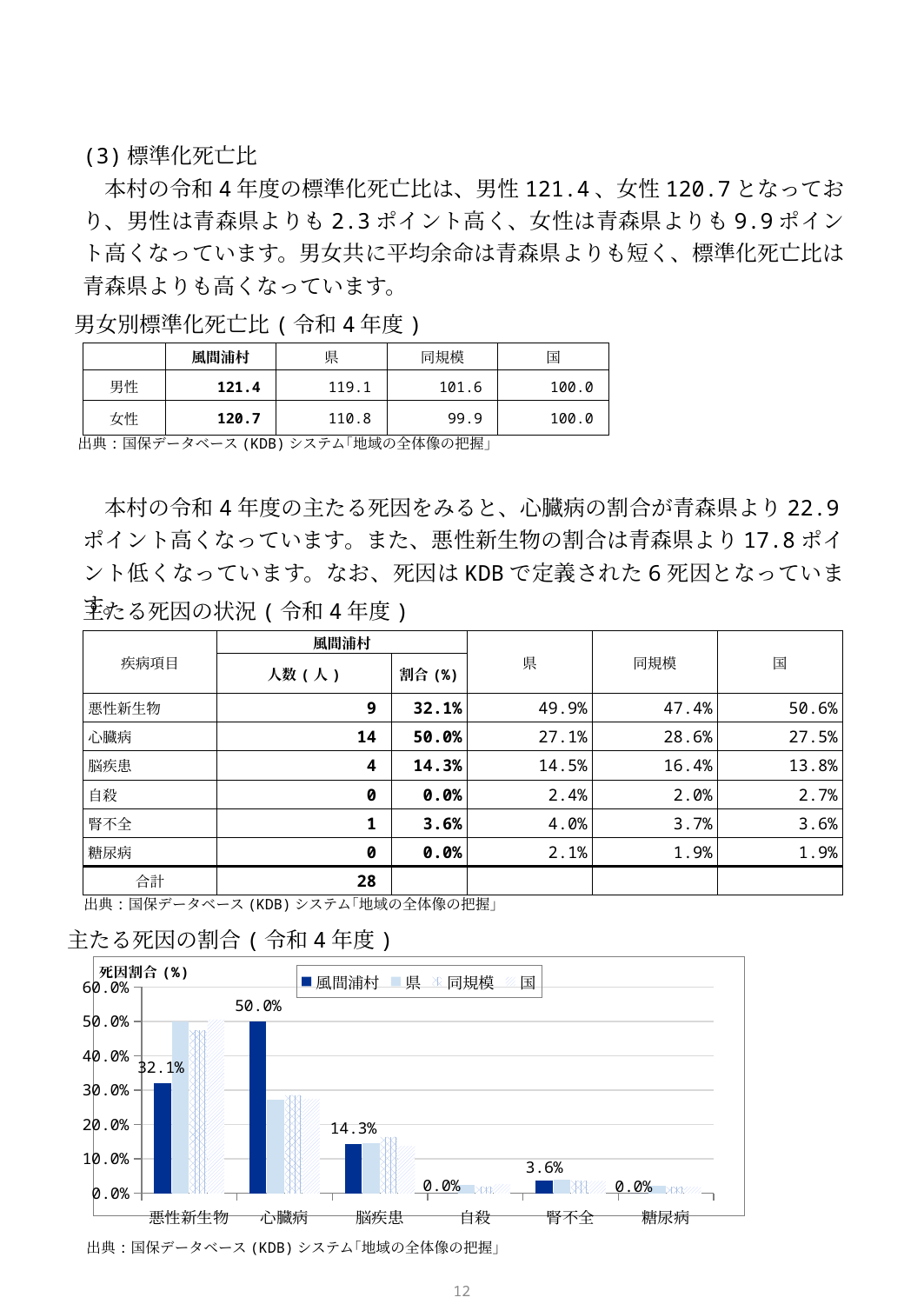
In the 主たる死因の割合（令和4年度） chart, what is the value for 風間浦村 in the 心臓病 category? 50.0% In the 主たる死因の割合（令和4年度） chart, what is the value for 風間浦村 in the 悪性新生物 category? 32.1% How many cause-of-death categories are shown on the x axis of the 主たる死因の割合（令和4年度） chart? 6 In the 主たる死因の割合（令和4年度） chart, what is the difference between the 風間浦村 values for 心臓病 and 悪性新生物? 17.9 percentage points What kind of chart is the 主たる死因の割合（令和4年度） chart? Bar chart In the 主たる死因の割合（令和4年度） chart, is the value for 県 in the 脳疾患 category greater or less than 10.0%? greater In the 主たる死因の割合（令和4年度） chart, which category has the highest value for 風間浦村? 心臓病 What is the label on the vertical axis of the 主たる死因の割合（令和4年度） chart? 死因割合(%) In the 主たる死因の割合（令和4年度） chart, is the value for 県 in the 心臓病 category greater or less than 20.0%? greater In the 主たる死因の割合（令和4年度） chart, what is the value for 風間浦村 in the 腎不全 category? 3.6% How many series does the legend of the 主たる死因の割合（令和4年度） chart list? 4 In the 主たる死因の割合（令和4年度） chart, which is larger for 風間浦村: 脳疾患 or 腎不全? 脳疾患